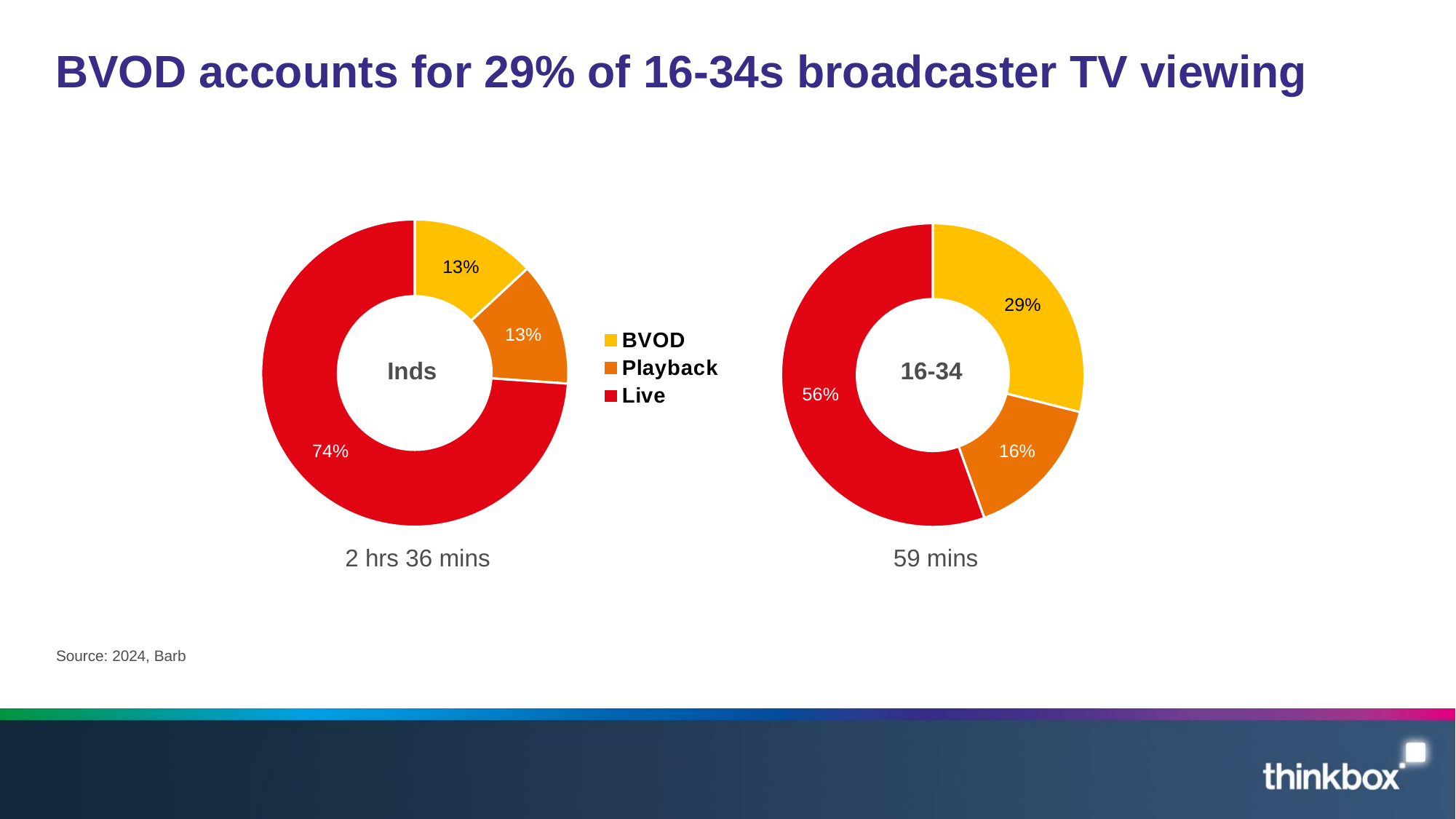
In the 16-34 donut chart, which category has the smallest share? Playback In the 16-34 donut chart, what share of viewing is Playback? 16% In the 16-34 donut chart, what share of viewing is BVOD? 29% What is the difference between the Live share in the Inds chart and the Live share in the 16-34 chart? 18 percentage points Is the BVOD share larger in the Inds chart or the 16-34 chart? 16-34 How many series does the legend list? 3 In the 16-34 donut chart, which category has the largest share? Live In the Inds donut chart, what share of viewing is BVOD? 13% What total viewing time is shown beneath the Inds donut chart? 2 hrs 36 mins In the Inds donut chart, what share of viewing is Live? 74% Which colour represents Playback in the legend? Orange What kind of chart is used on this slide? Donut (pie) chart